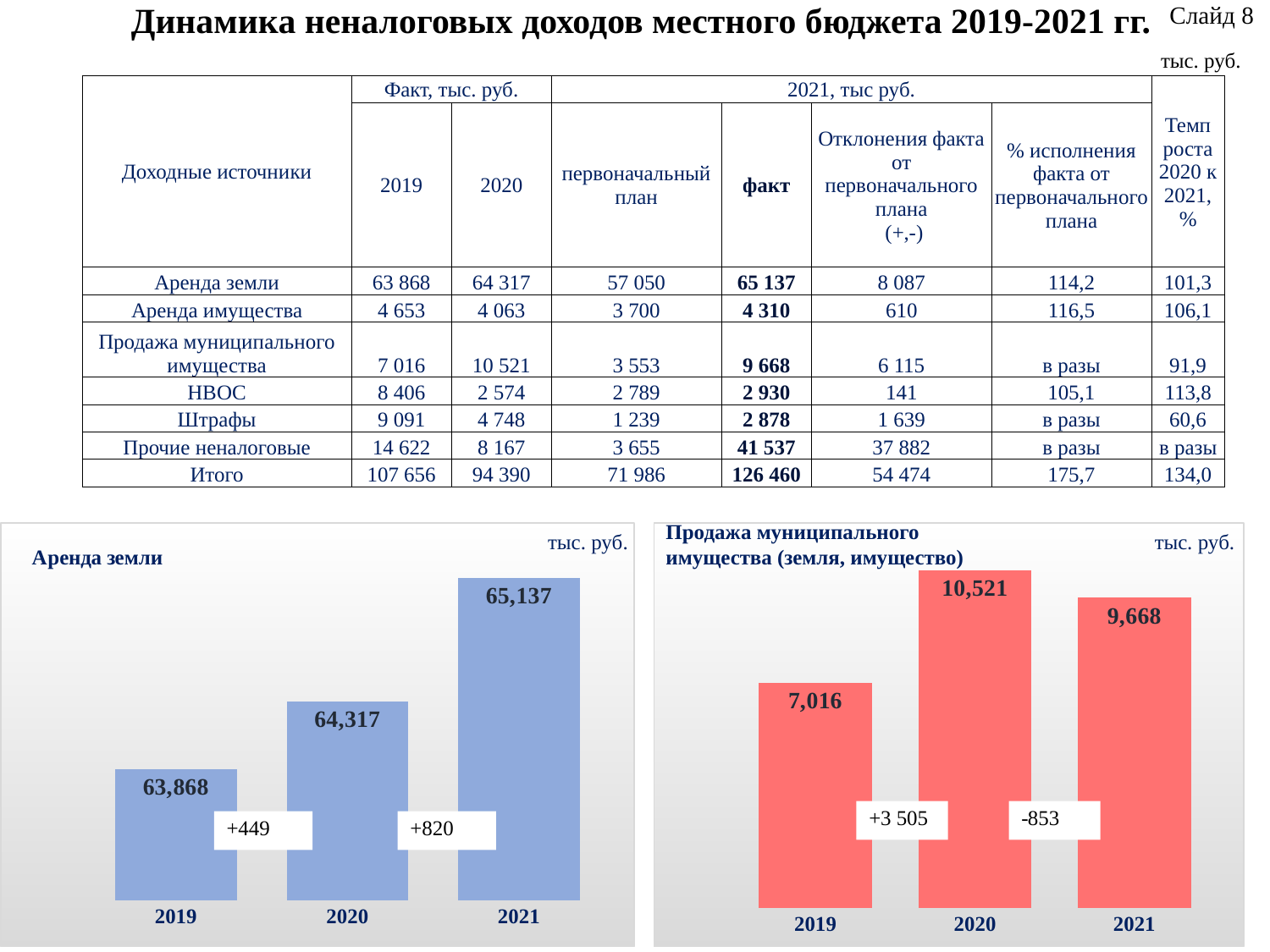
In the 'Аренда земли' chart, what is the difference between the 2021 and 2020 values? 820 In the 'Продажа муниципального имущества (земля, имущество)' chart, which year has the highest value? 2020 In the 'Аренда земли' chart, what is the value for 2021? 65,137 In the 'Продажа муниципального имущества (земля, имущество)' chart, which is larger: the value for 2019 or the value for 2021? 2021 In the 'Аренда земли' chart, what is the value for 2019? 63,868 In the 'Аренда земли' chart, which year has the lowest value? 2019 In the 'Продажа муниципального имущества (земля, имущество)' chart, which year has the lowest value? 2019 In the 'Продажа муниципального имущества (земля, имущество)' chart, what is the difference between the 2020 and 2021 values? 853 What kind of chart is the 'Аренда земли' chart? bar chart In the 'Продажа муниципального имущества (земля, имущество)' chart, what is the value for 2020? 10,521 In the 'Аренда земли' chart, do the values rise or fall from 2019 to 2021? rise How many years are plotted in the 'Аренда земли' chart? 3